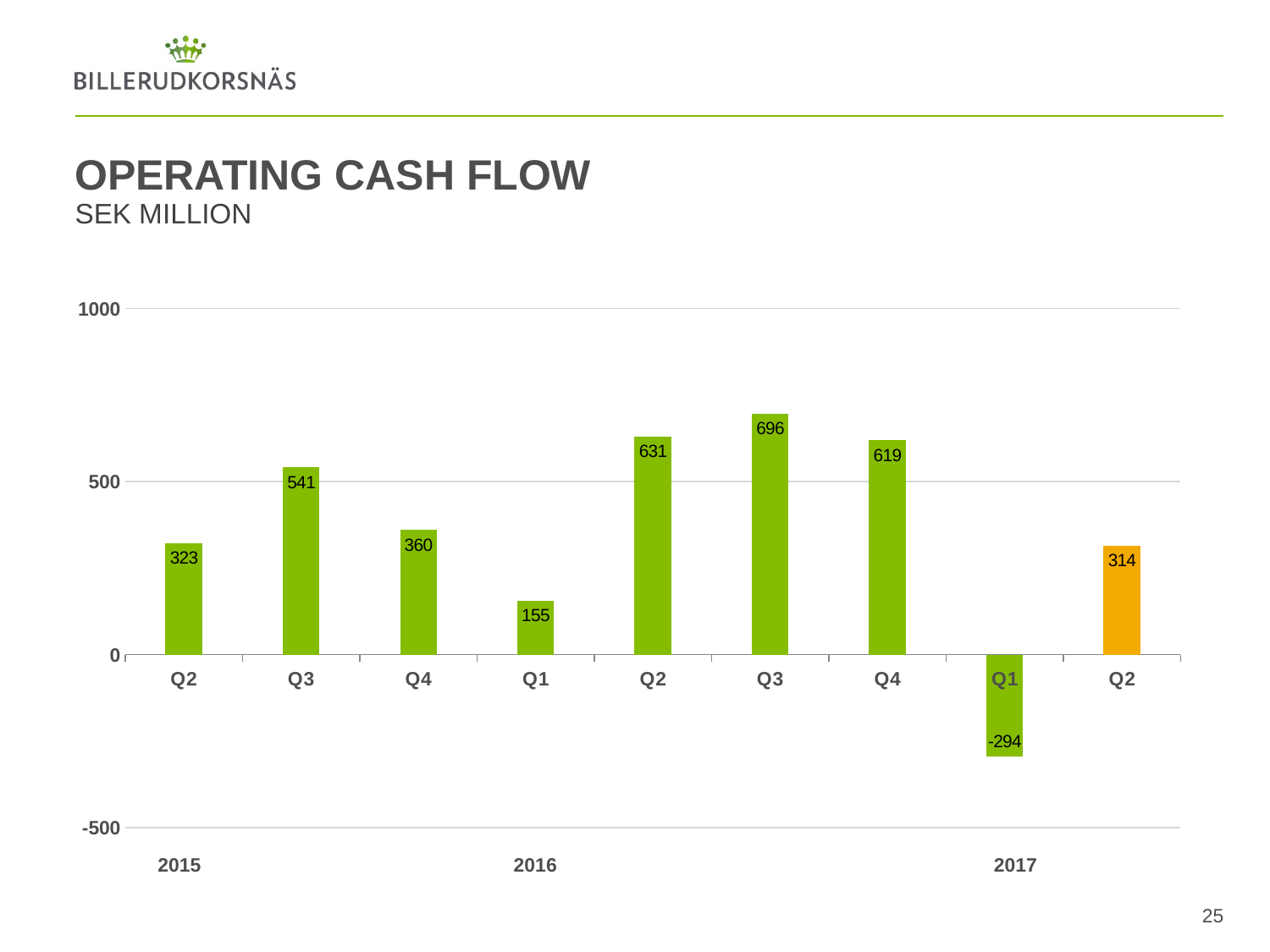
Which quarter has the lowest operating cash flow? Q1 2017 What is the operating cash flow for Q2 2017? 314 What is the operating cash flow for Q1 2017? -294 What kind of chart is shown on the slide? Bar chart What is the operating cash flow for Q2 2015? 323 Which quarter has the highest operating cash flow? Q3 2016 What is the difference between the operating cash flow in Q2 2016 and Q1 2016? 476 What is the operating cash flow for Q3 2016? 696 What unit is the operating cash flow shown in? SEK million Is the operating cash flow for Q4 2016 greater or less than 500? greater Which is larger, the operating cash flow in Q3 2015 or Q4 2015? Q3 2015 How many quarters are shown in the chart? 9